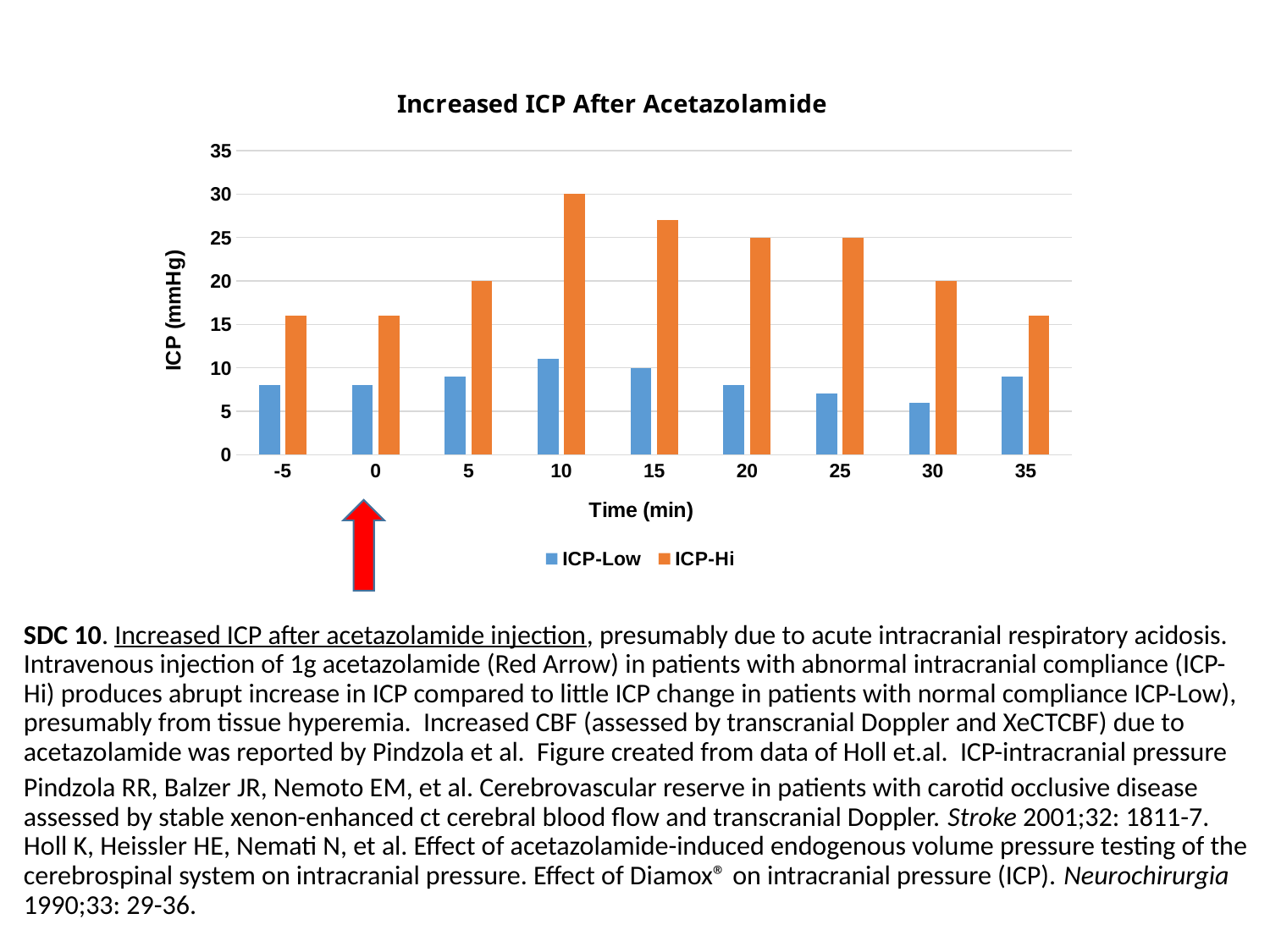
What is the ICP-Hi value at 5 min? 20 What is the title of the chart? Increased ICP After Acetazolamide What type of chart is shown on the slide? bar chart Is the ICP-Hi value at 15 min greater or less than 25? greater At 0 min, which series has the larger value, ICP-Low or ICP-Hi? ICP-Hi At which time point is ICP-Hi highest? 10 Is the ICP-Low value at 0 min greater or less than 10? less What is the ICP-Low value at 15 min? 10 What is the ICP-Hi value at 10 min? 30 How many time points are shown on the x axis? 9 What is the difference between the ICP-Hi value at 10 min and at 5 min? 10 How many series does the legend list? 2